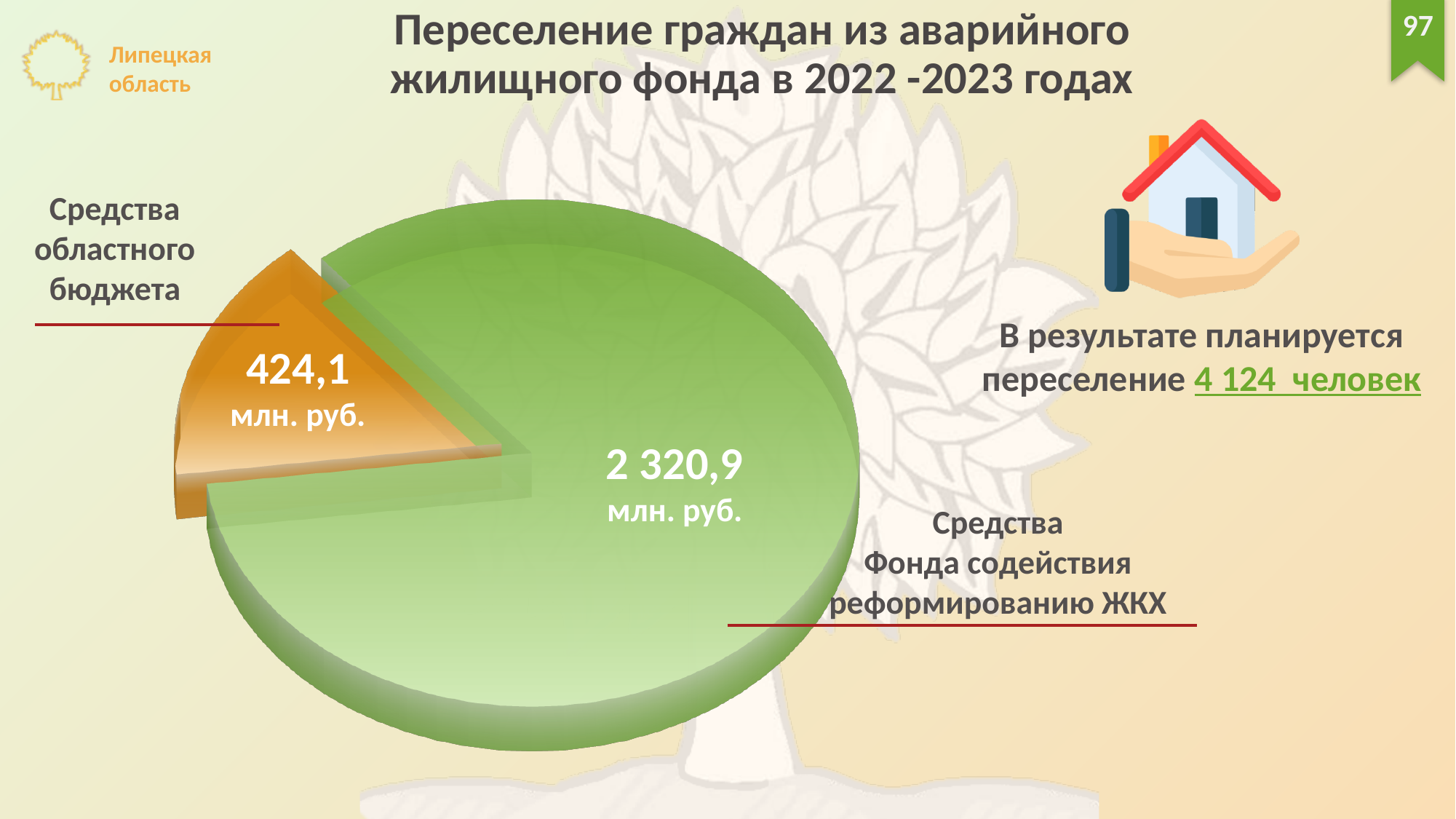
What is the difference between the Фонд содействия реформированию ЖКХ funds and the regional budget funds, in млн. руб.? 1 896,8 млн. руб. What type of chart is shown on the slide? Pie chart How many slices does the pie chart have? 2 Which is larger: the funds from the regional budget (областного бюджета) or the funds from the Фонд содействия реформированию ЖКХ? Средства Фонда содействия реформированию ЖКХ What colour is the slice representing "Средства Фонда содействия реформированию ЖКХ"? Green What is the value of the slice labelled "Средства областного бюджета"? 424,1 млн. руб. What is the value of the slice labelled "Средства Фонда содействия реформированию ЖКХ"? 2 320,9 млн. руб. What colour is the slice representing "Средства областного бюджета"? Orange What is the total of the two slices in the pie chart, in млн. руб.? 2 745,0 млн. руб. Which slice of the pie chart is the smallest? Средства областного бюджета Which slice of the pie chart is the largest? Средства Фонда содействия реформированию ЖКХ According to the slide, how many people are planned to be resettled as a result? 4 124 человек